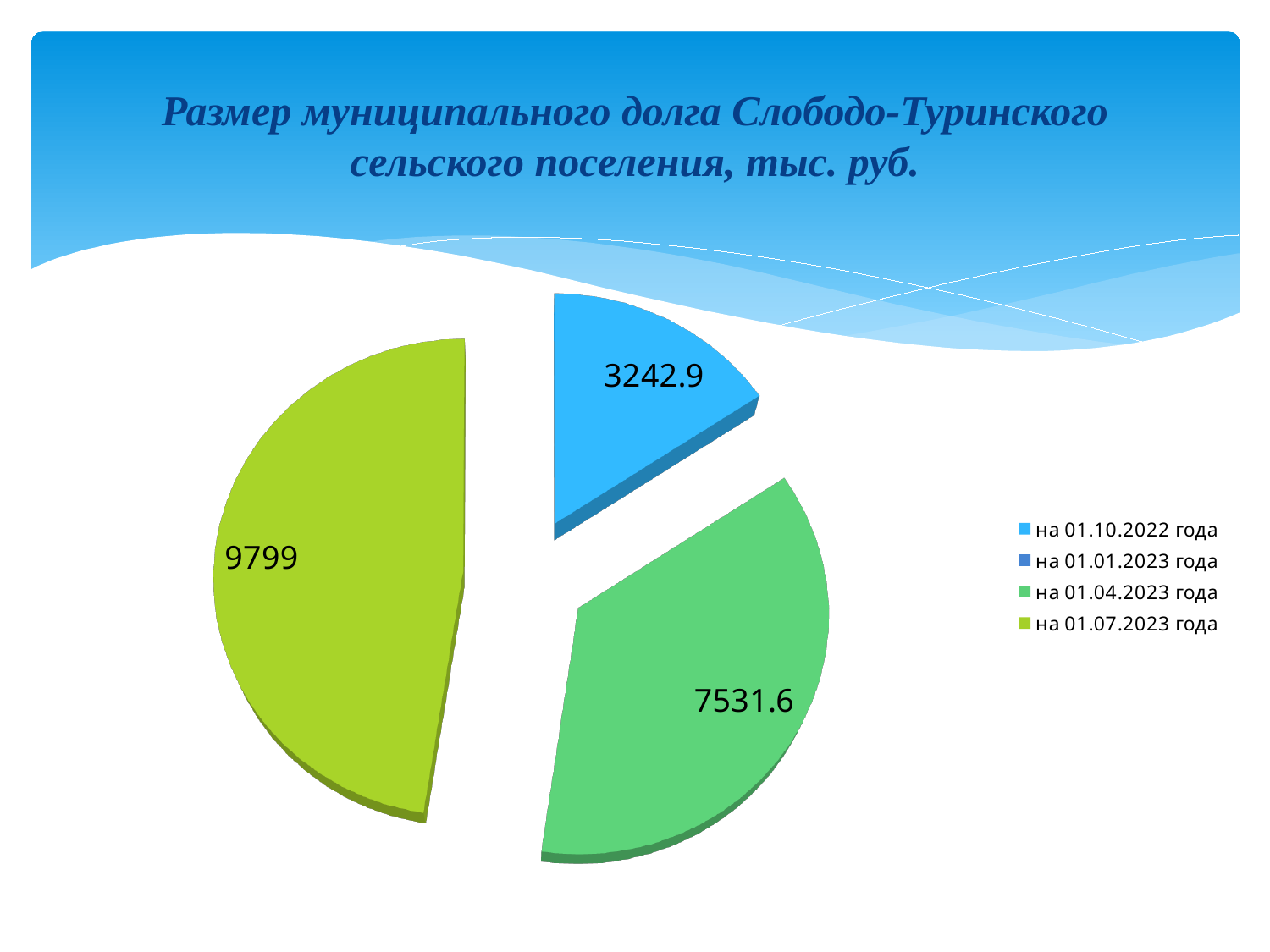
What is the value of the slice for на 01.04.2023 года? 7531.6 What is the difference between the values for на 01.04.2023 года and на 01.10.2022 года? 4288.7 How many slices with data labels are visible in the pie chart? 3 What type of chart is shown on the slide? pie chart What is the difference between the values for на 01.07.2023 года and на 01.04.2023 года? 2267.4 Which is larger, the value for на 01.04.2023 года or the value for на 01.10.2022 года? на 01.04.2023 года Which date has the largest slice in the pie chart? на 01.07.2023 года What is the value of the slice for на 01.07.2023 года? 9799 What is the value of the slice for на 01.10.2022 года? 3242.9 How many entries does the legend list? 4 What is the title of the chart? Размер муниципального долга Слободо-Туринского сельского поселения, тыс. руб. Which of the visible slices is the smallest? на 01.10.2022 года